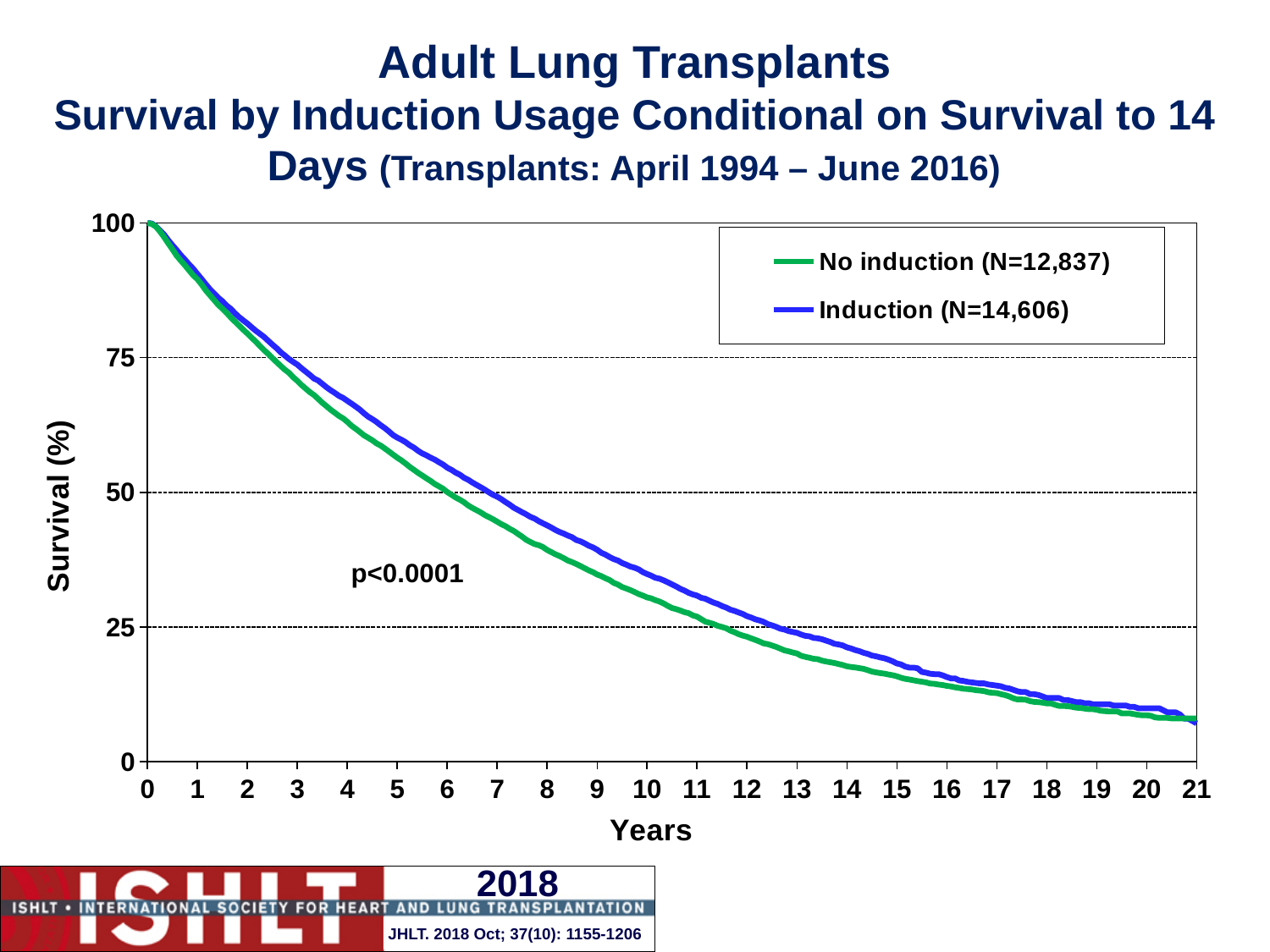
Is the value for Induction at year 10 greater or less than 25? greater Is the value for No induction at year 5 greater or less than 50? greater Is the value for No induction at year 15 greater or less than 25? less How many series does the legend list? 2 What is the survival value for both groups at year 0? 100 At year 5, which group has higher survival, No induction or Induction? Induction What is the N for the No induction group shown in the legend? N=12,837 Do the survival curves rise or fall as years increase? fall What p-value is printed on the chart? p<0.0001 What kind of chart is shown on the slide? line chart